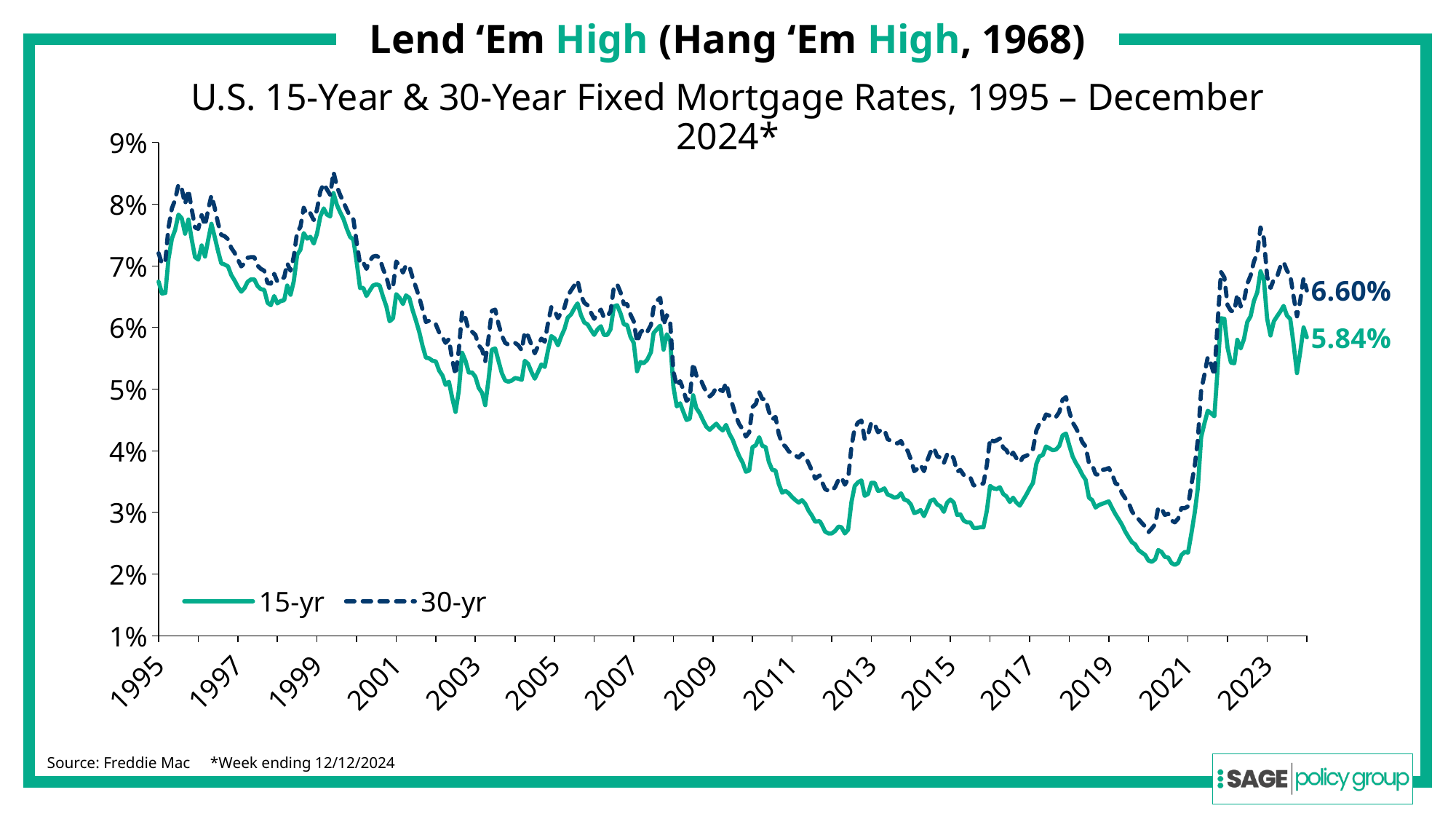
What is the source cited for the chart data? Freddie Mac What is the difference between the latest 30-yr value (6.60%) and the latest 15-yr value (5.84%)? 0.76 percentage points Which series is drawn with a dashed line? 30-yr Do the mortgage rates rise or fall between 2021 and 2023? Rise Is the value for the 15-yr series in 2000 greater or less than 7%? greater How many series does the legend list? 2 At the end of the series, which rate is higher, the 15-yr or the 30-yr? 30-yr What is the latest value shown for the 15-yr series? 5.84% Is the value for the 15-yr series in early 2021 greater or less than 3%? less What kind of chart is shown on the slide? Line chart What is the latest value shown for the 30-yr series? 6.60% Is the value for the 30-yr series in 2013 greater or less than 5%? less